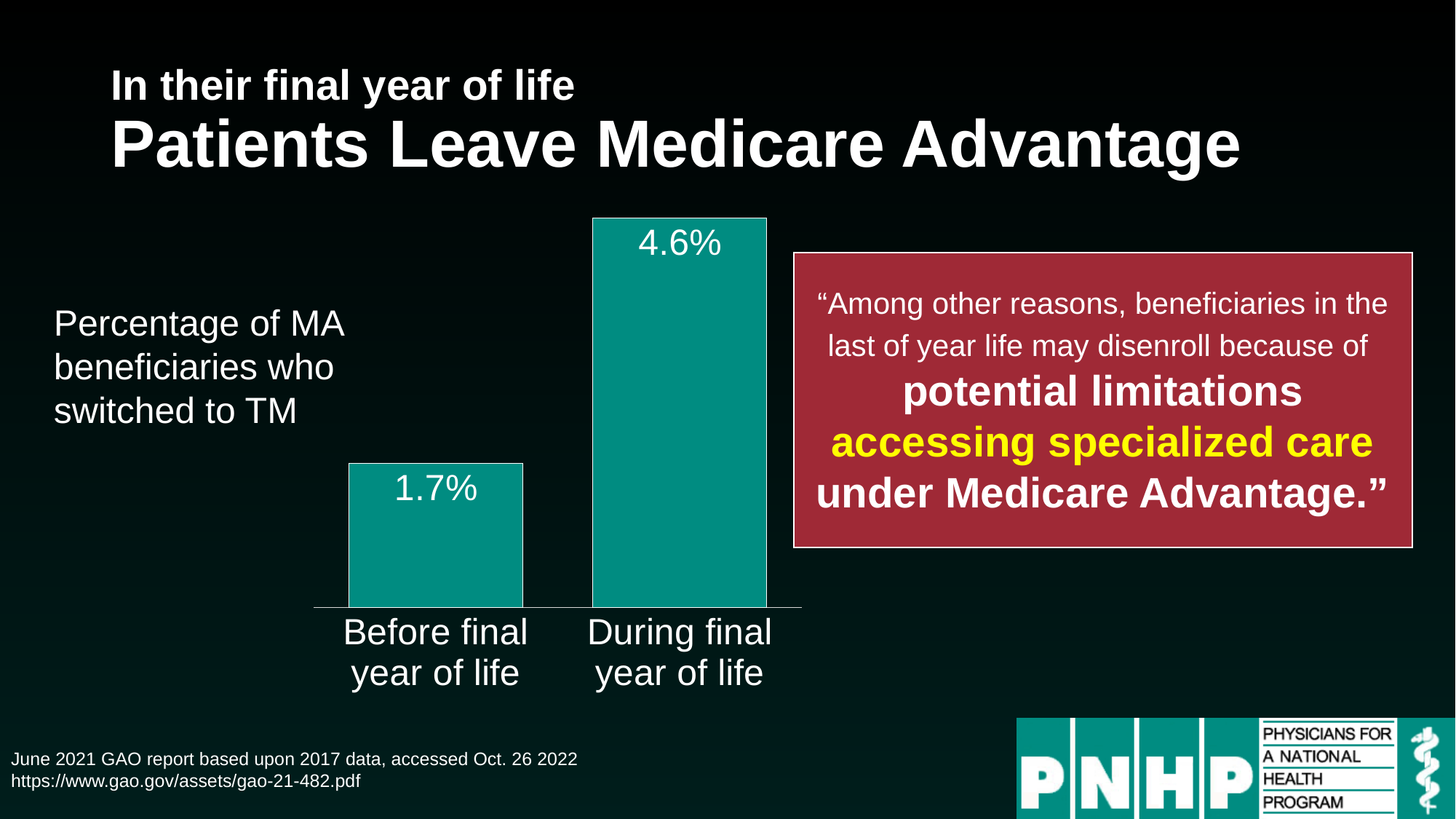
Which category has the lower percentage of MA beneficiaries who switched to TM? Before final year of life What percentage of MA beneficiaries switched to TM during their final year of life? 4.6% What percentage of MA beneficiaries switched to TM before their final year of life? 1.7% What does the chart measure, according to the label to its left? Percentage of MA beneficiaries who switched to TM How many categories are shown in the bar chart? 2 Which category has the higher percentage of MA beneficiaries who switched to TM? During final year of life What is the difference in percentage points between the 'During final year of life' and 'Before final year of life' bars? 2.9 What colour are the bars in the chart? teal Is the value for 'Before final year of life' larger or smaller than the value for 'During final year of life'? smaller What kind of chart is shown on the slide? bar chart Do the values rise or fall from 'Before final year of life' to 'During final year of life'? rise